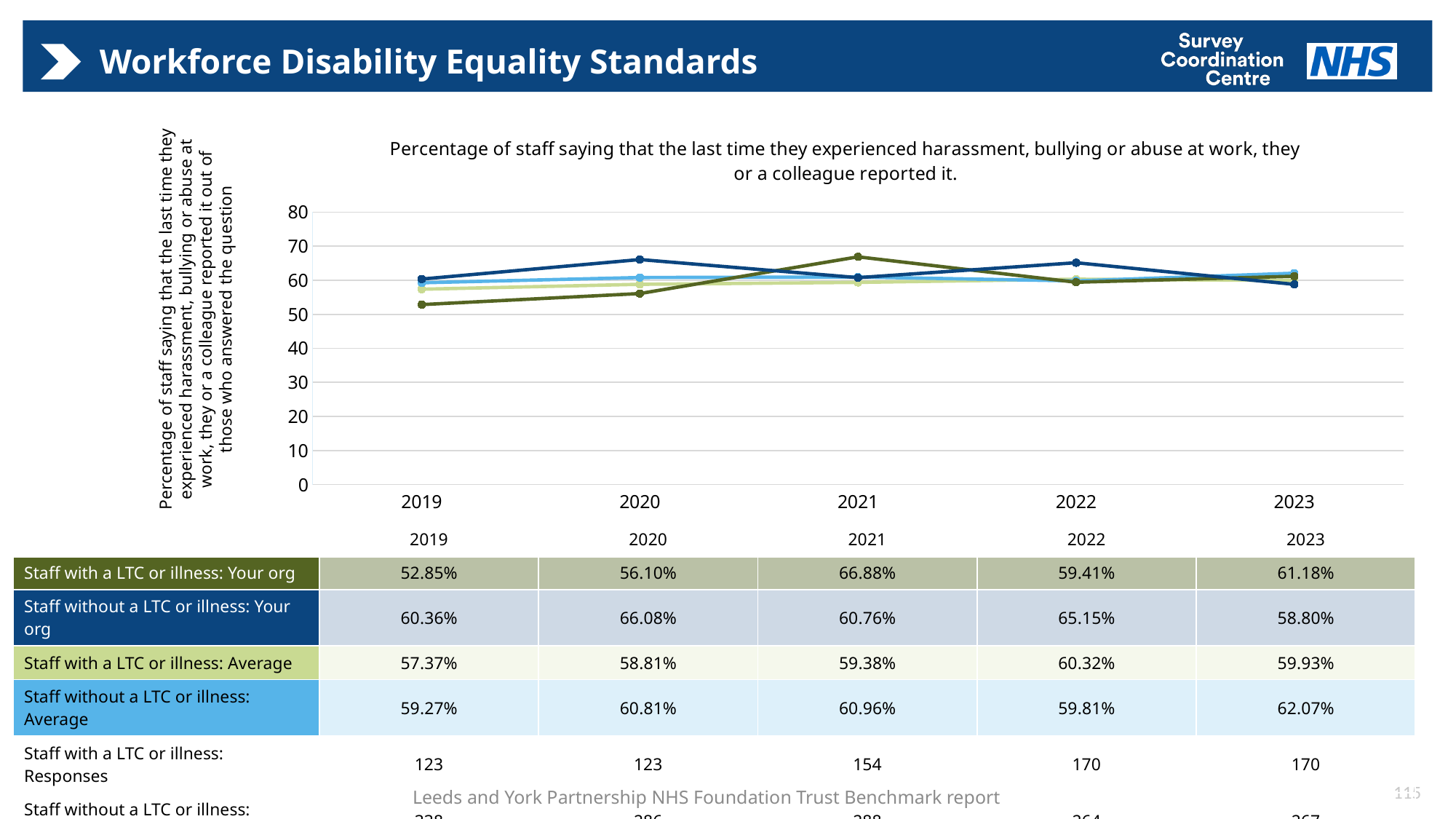
What is the value for 'Staff with a LTC or illness: Your org' in 2021? 66.88% Is the value for 'Staff with a LTC or illness: Your org' in 2019 greater or less than 60? less In which year is the value for 'Staff with a LTC or illness: Your org' lowest? 2019 Does the value for 'Staff with a LTC or illness: Average' rise or fall from 2019 to 2022? rise How many years are plotted along the x axis of the chart? 5 What is the difference between 'Staff without a LTC or illness: Your org' and 'Staff with a LTC or illness: Your org' in 2019? 7.51 percentage points What kind of chart is shown on the slide? line chart How many data series are plotted on the chart? 4 What is the value for 'Staff without a LTC or illness: Your org' in 2020? 66.08% In which year is the value for 'Staff with a LTC or illness: Your org' highest? 2021 What is the value for 'Staff without a LTC or illness: Average' in 2023? 62.07% In 2022, which is larger: 'Staff with a LTC or illness: Your org' or 'Staff without a LTC or illness: Your org'? Staff without a LTC or illness: Your org